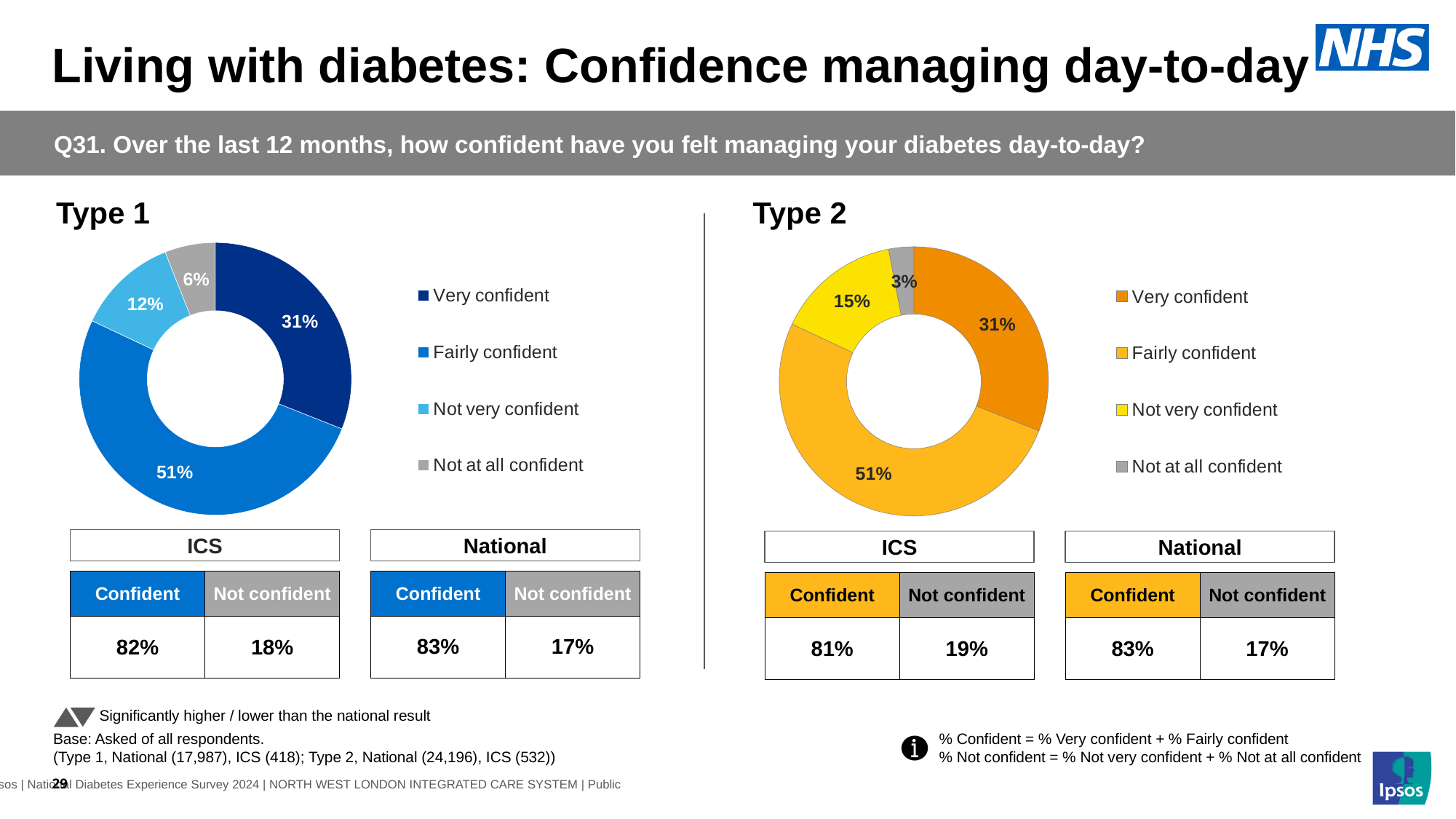
In the Type 1 chart, what is the difference between the Fairly confident and Very confident shares? 20 percentage points What kind of chart is used for Type 1? Doughnut (pie) chart In the Type 2 chart, what percentage of respondents were Not at all confident? 3% In the Type 1 chart, what percentage of respondents were Not at all confident? 6% In the Type 1 chart, which is larger: Not very confident or Not at all confident? Not very confident In the Type 2 chart, which category has the smallest share? Not at all confident How many categories does the legend of the Type 2 chart list? 4 In the Type 2 chart, what is the difference between the Not very confident and Not at all confident shares? 12 percentage points In the Type 2 chart, what percentage of respondents were Not very confident? 15% In the Type 1 chart, what colour represents Fairly confident? Blue In the Type 1 chart, which category has the largest share? Fairly confident In the Type 1 chart, what percentage of respondents were Very confident? 31%